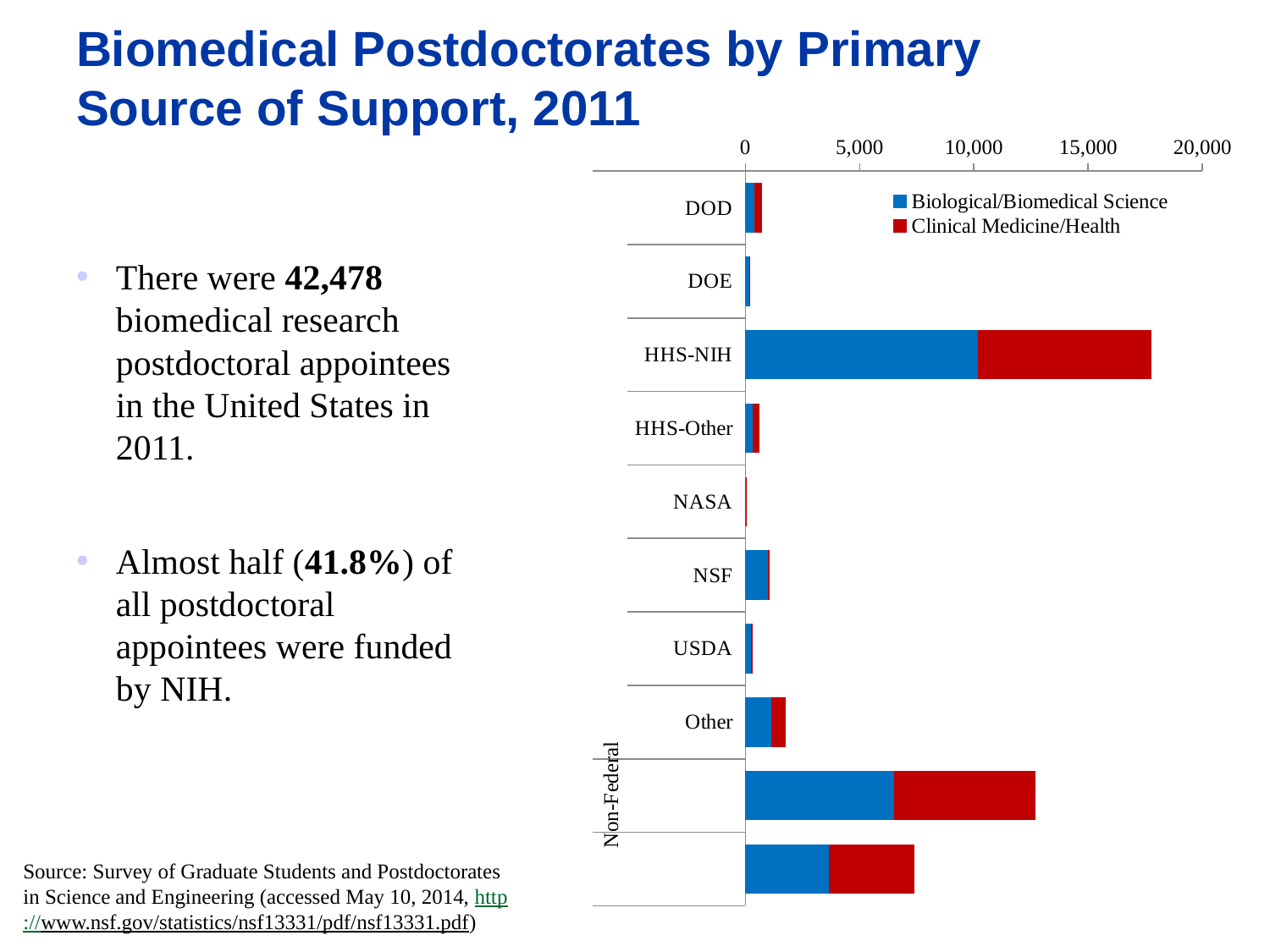
Which has a larger total, NSF or USDA? NSF Is the total value for Other greater or less than 5,000? less Is the total value for NSF greater or less than 5,000? less Which source of support has the longest bar? HHS-NIH What kind of chart is shown on the slide? Bar chart Which has a larger total, DOD or DOE? DOD Is the total value for HHS-NIH greater or less than 15,000? greater Which labeled source of support has the shortest bar? NASA How many series does the legend list? 2 Which series is shown in red in the legend? Clinical Medicine/Health What is the highest value shown on the horizontal axis? 20,000